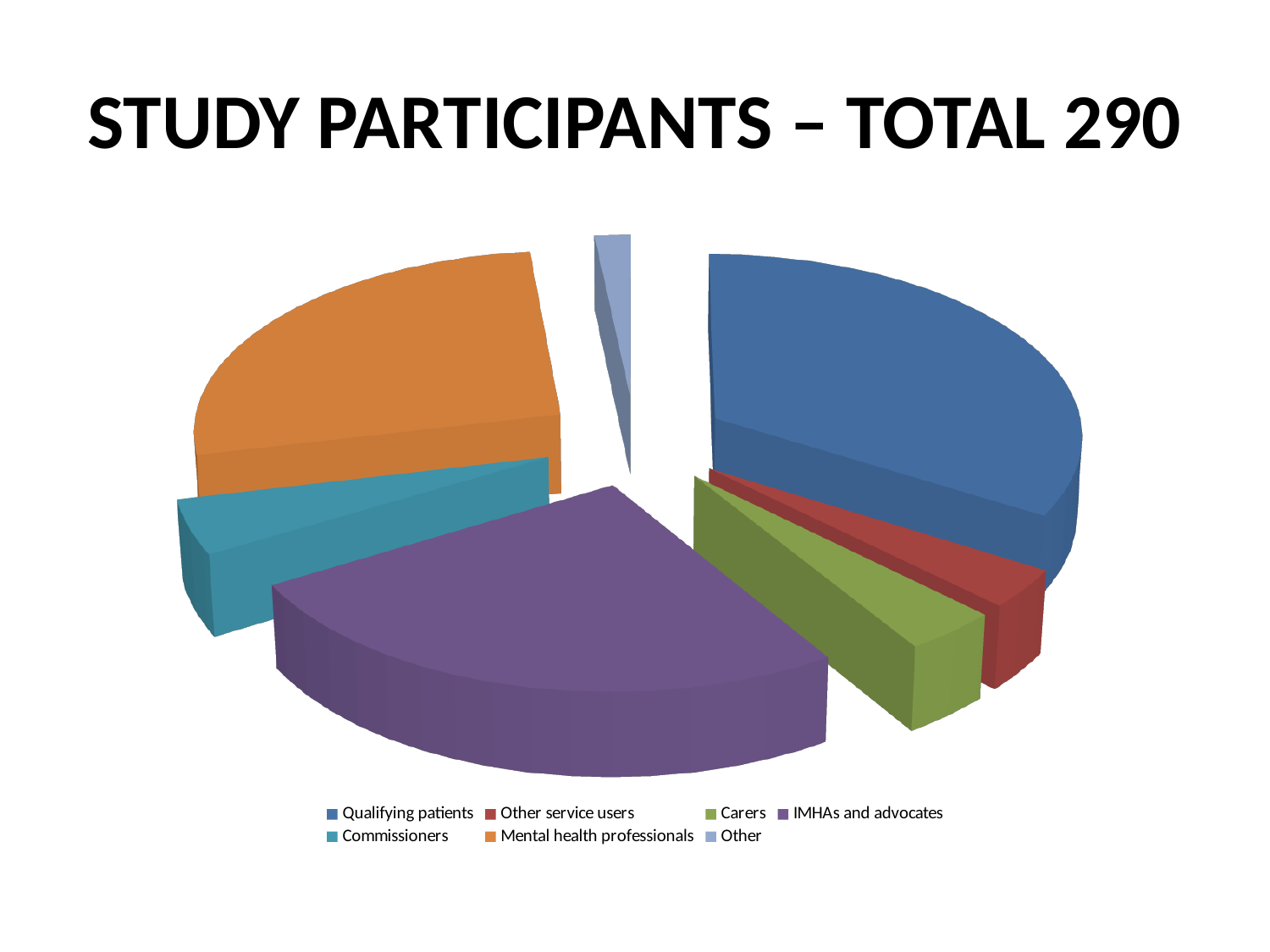
Which slice is larger: Qualifying patients or Other service users? Qualifying patients Which slice is larger: Mental health professionals or Commissioners? Mental health professionals What is the title of the chart slide? STUDY PARTICIPANTS – TOTAL 290 How many categories does the pie chart legend list? 7 What colour is the slice for IMHAs and advocates? Purple Which slice is larger: IMHAs and advocates or Carers? IMHAs and advocates What is the total number of study participants stated in the title? 290 Which category has the smallest slice of the pie? Other What kind of chart is shown on the slide? Pie chart